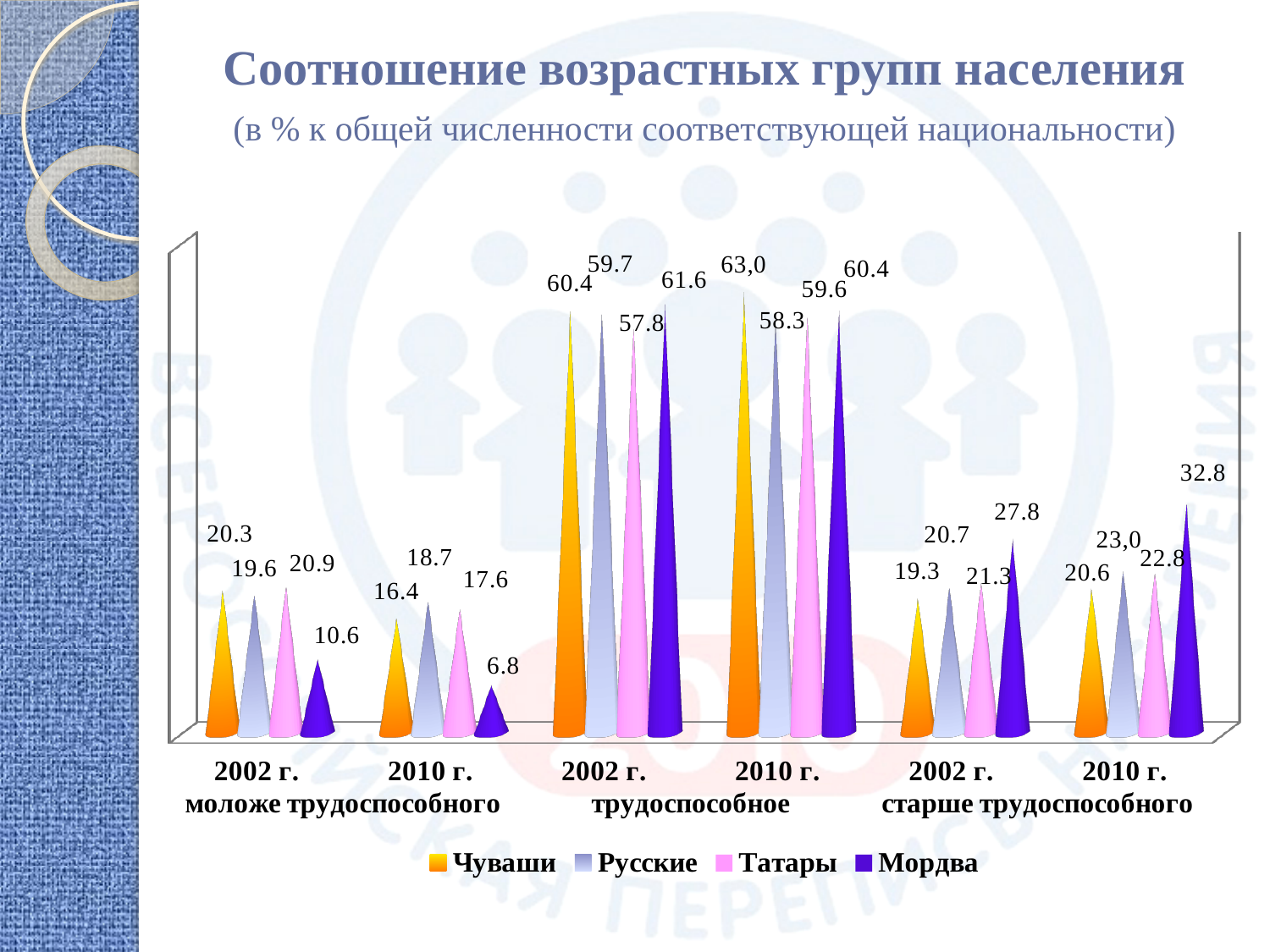
What is the value for Мордва in the 2010 г. моложе трудоспособного group? 6.8 Which nationality has the lowest value in the 2002 г. моложе трудоспособного group? Мордва Which colour represents Татары in the legend? Pink What is the value for Чуваши in the 2010 г. трудоспособное group? 63,0 How many category groups are shown along the x axis? 6 What is the difference between the Мордва values for 2010 г. and 2002 г. in the старше трудоспособного group? 5.0 What kind of chart is shown on the slide? Bar chart What is the value for Русские in the 2010 г. старше трудоспособного group? 23,0 Which nationality has the highest value in the 2010 г. старше трудоспособного group? Мордва Which is larger: the Чуваши value for 2002 г. моложе трудоспособного or the Чуваши value for 2010 г. моложе трудоспособного? 2002 г. моложе трудоспособного How many series does the legend list? 4 What is the value for Татары in the 2002 г. старше трудоспособного group? 21.3